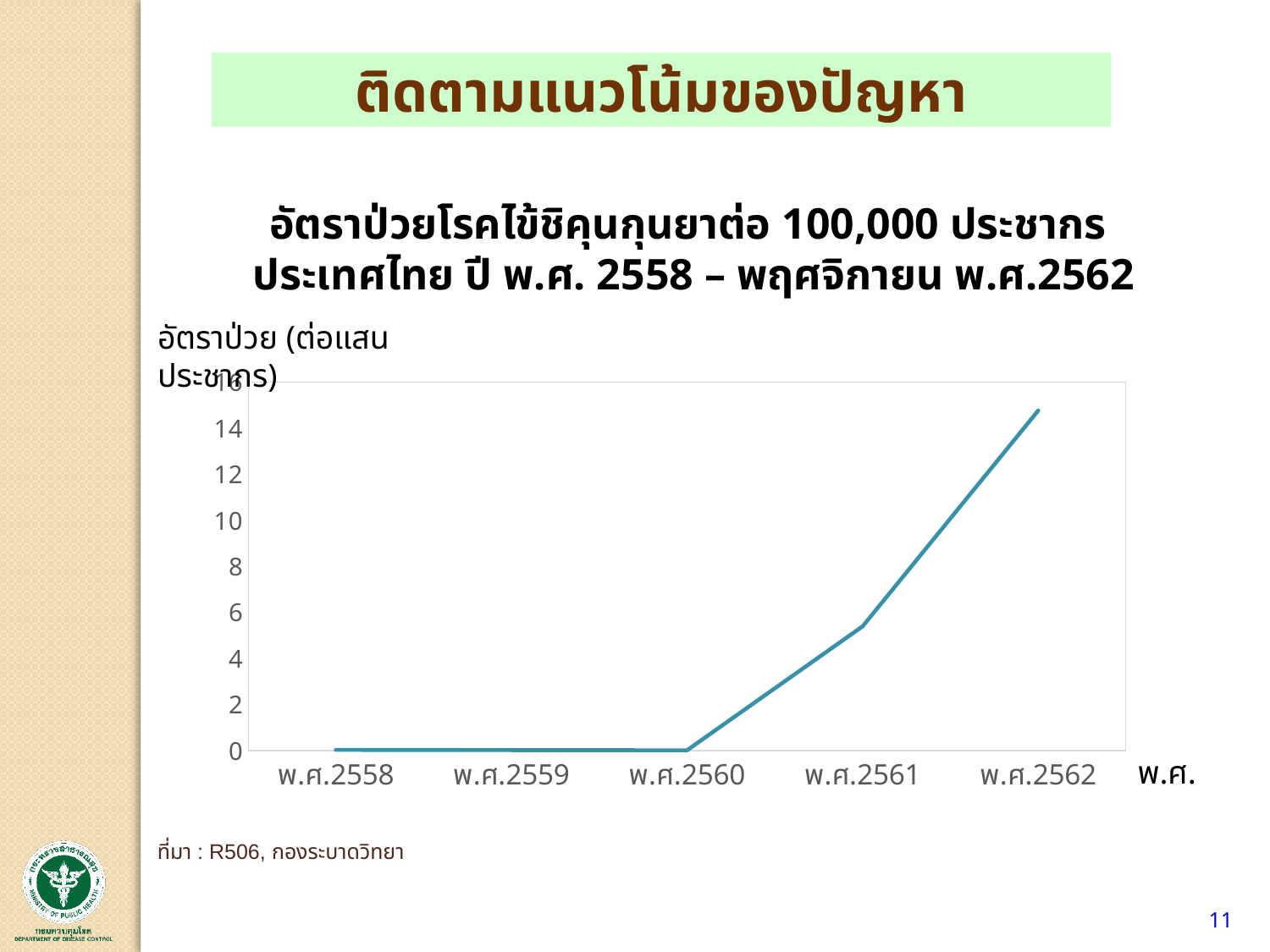
Do the values rise or fall from พ.ศ.2560 to พ.ศ.2562? rise What is the highest tick value shown on the y axis of the chart? 16 What is the source cited below the chart? R506, กองระบาดวิทยา Is the value for พ.ศ.2562 greater or less than 10? greater Is the value for พ.ศ.2560 greater or less than 2? less Is the value for พ.ศ.2561 greater or less than 8? less What kind of chart is shown on the slide? line chart Which is larger, the value for พ.ศ.2561 or the value for พ.ศ.2562? พ.ศ.2562 How many years are plotted along the x axis of the chart? 5 Which year has the highest rate in the chart? พ.ศ.2562